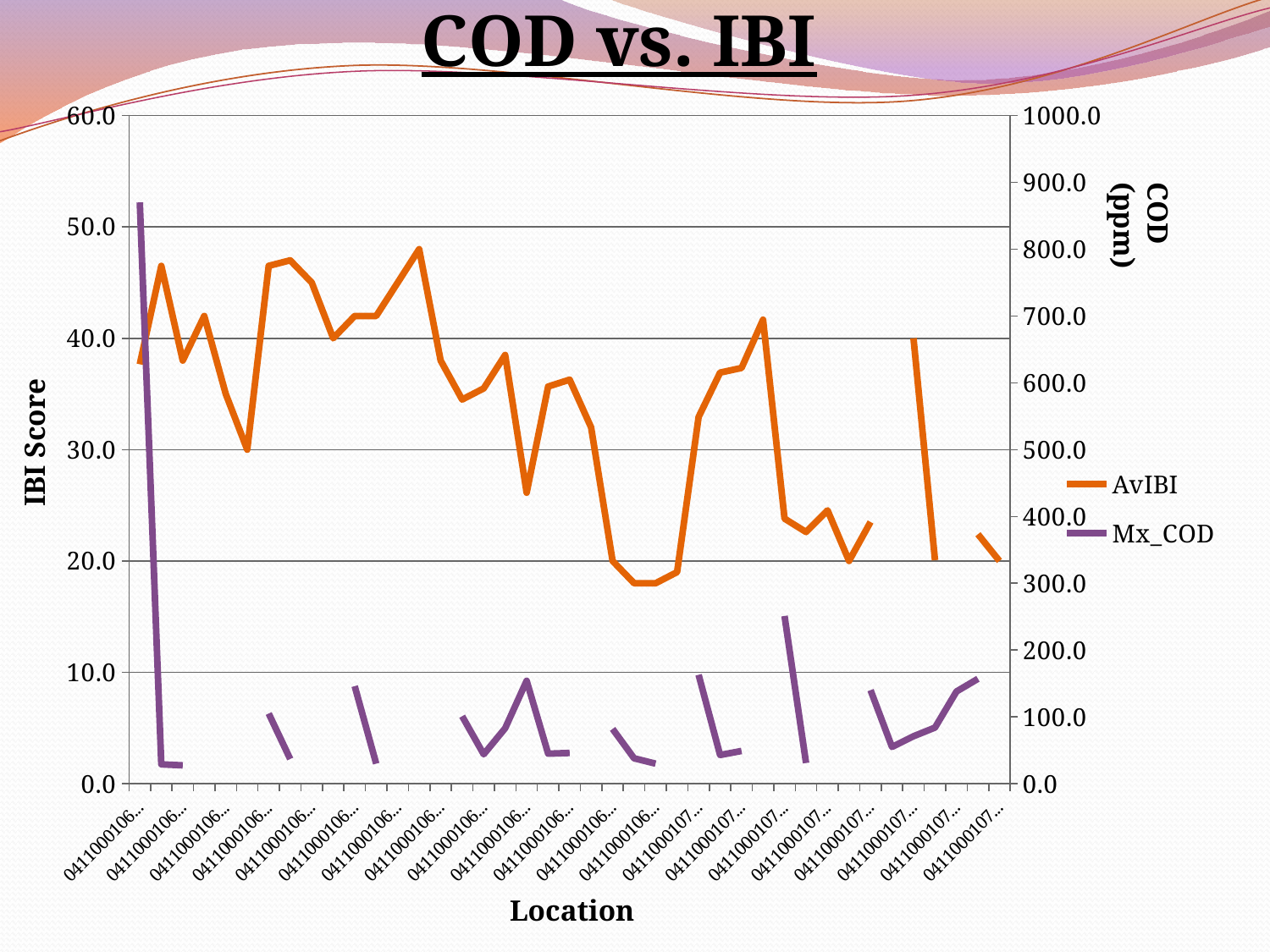
How many series does the legend list? 2 Is the last AvIBI value on the right greater or less than 30? less What is the title of the chart? COD vs. IBI What are the two series named in the legend? AvIBI and Mx_COD Is the first AvIBI value on the left greater or less than 30? greater Which is larger, the first AvIBI value on the left or the last AvIBI value on the right? the first AvIBI value Is the highest Mx_COD value greater or less than 800? greater Overall, do the AvIBI values rise or fall from left to right along the x axis? fall What kind of chart is shown on the slide? line chart Which series reaches the highest point relative to its own axis, AvIBI or Mx_COD? Mx_COD